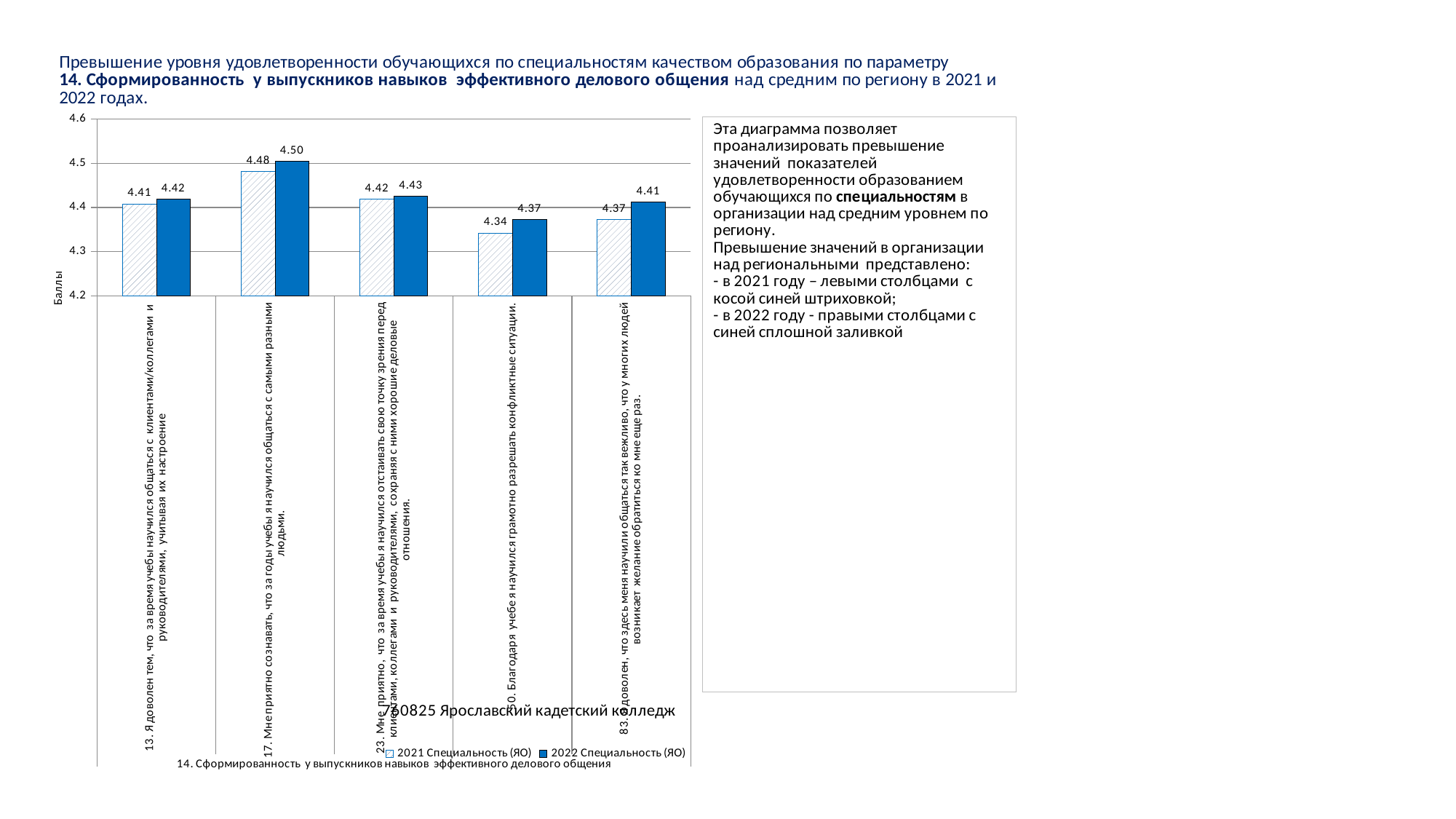
What kind of chart is shown on the slide? bar chart How many series does the chart legend list? 2 Is the 2021 Специальность (ЯО) value for statement 17 greater or less than 4.4? greater How many categories (statements) are plotted on the x axis of the chart? 5 What is the 2022 Специальность (ЯО) value for statement 17 (Мне приятно сознавать, что за годы учебы я научился общаться с самыми разными людьми)? 4.50 Which statement has the highest 2022 Специальность (ЯО) value? 17 What is the difference between the 2022 and 2021 values for statement 83? 0.04 What is the label of the y axis of the chart? Баллы Which is larger for statement 13: the 2021 value or the 2022 value? 2022 value What is the 2021 Специальность (ЯО) value for statement 83? 4.37